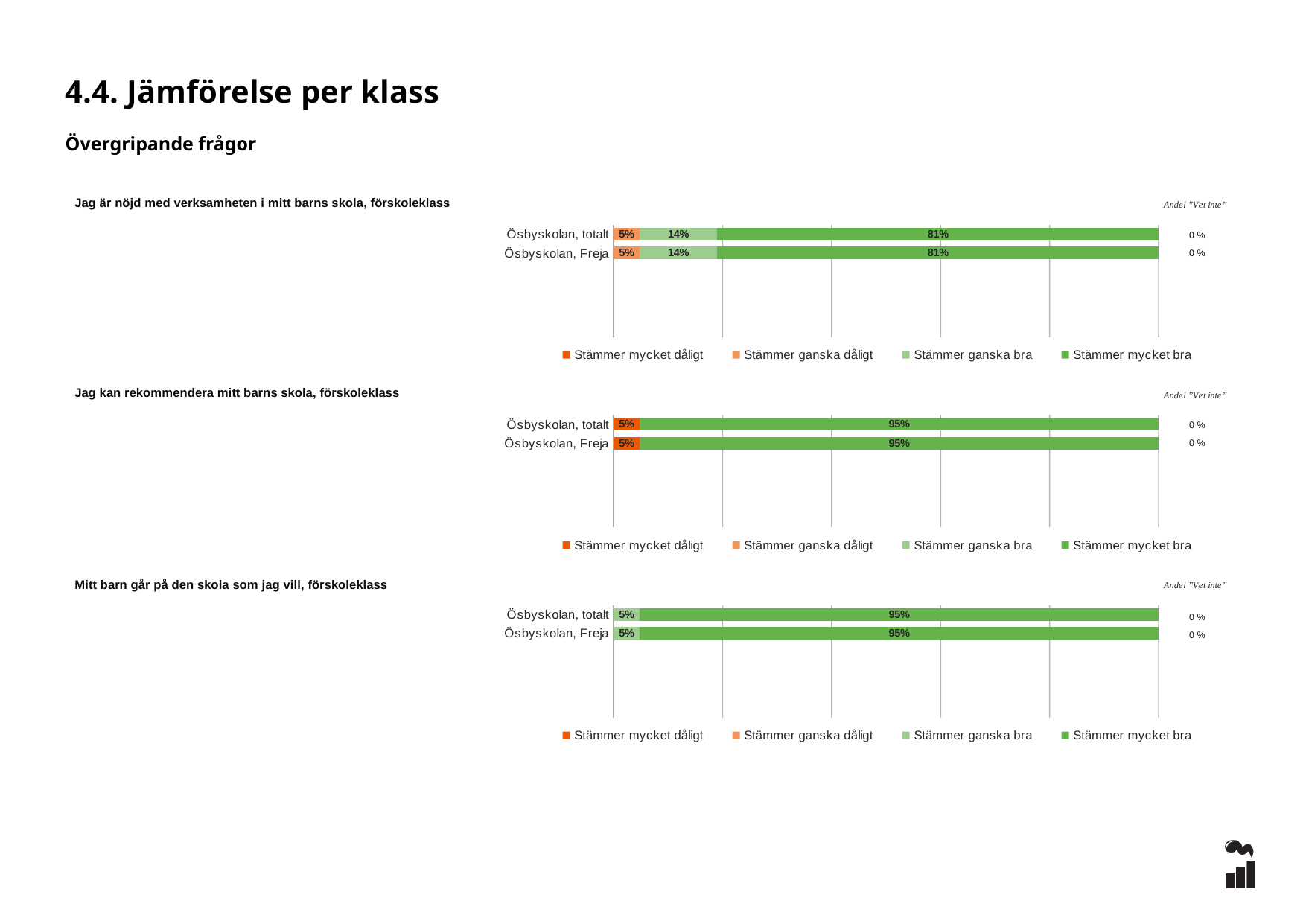
In the chart 'Jag kan rekommendera mitt barns skola, förskoleklass', what is the total of the segments in the bar for Ösbyskolan, Freja? 100% In the chart 'Jag är nöjd med verksamheten i mitt barns skola, förskoleklass', which is larger for Ösbyskolan, Freja: the 'Stämmer ganska bra' segment or the 'Stämmer mycket bra' segment? Stämmer mycket bra In the chart 'Mitt barn går på den skola som jag vill, förskoleklass', what is the value of the smaller segment for Ösbyskolan, Freja? 5% In the chart 'Jag är nöjd med verksamheten i mitt barns skola, förskoleklass', what is the value of the largest segment for Ösbyskolan, totalt? 81% In the chart 'Jag kan rekommendera mitt barns skola, förskoleklass', what is the value of the 'Stämmer mycket bra' segment for Ösbyskolan, totalt? 95% In the chart 'Jag är nöjd med verksamheten i mitt barns skola, förskoleklass', what is the value of the light green 'Stämmer ganska bra' segment for Ösbyskolan, Freja? 14% In the chart 'Jag är nöjd med verksamheten i mitt barns skola, förskoleklass', what is the difference between the 81% segment and the 14% segment for Ösbyskolan, totalt? 67 percentage points What is the 'Andel "Vet inte"' value shown for Ösbyskolan, totalt in the chart 'Mitt barn går på den skola som jag vill, förskoleklass'? 0 % What kind of chart is used for 'Jag kan rekommendera mitt barns skola, förskoleklass'? Stacked horizontal bar chart How many bars (categories) are shown in the chart 'Mitt barn går på den skola som jag vill, förskoleklass'? 2 How many series does the legend list for the chart 'Jag är nöjd med verksamheten i mitt barns skola, förskoleklass'? 4 What is the last legend entry listed for the chart 'Jag kan rekommendera mitt barns skola, förskoleklass'? Stämmer mycket bra